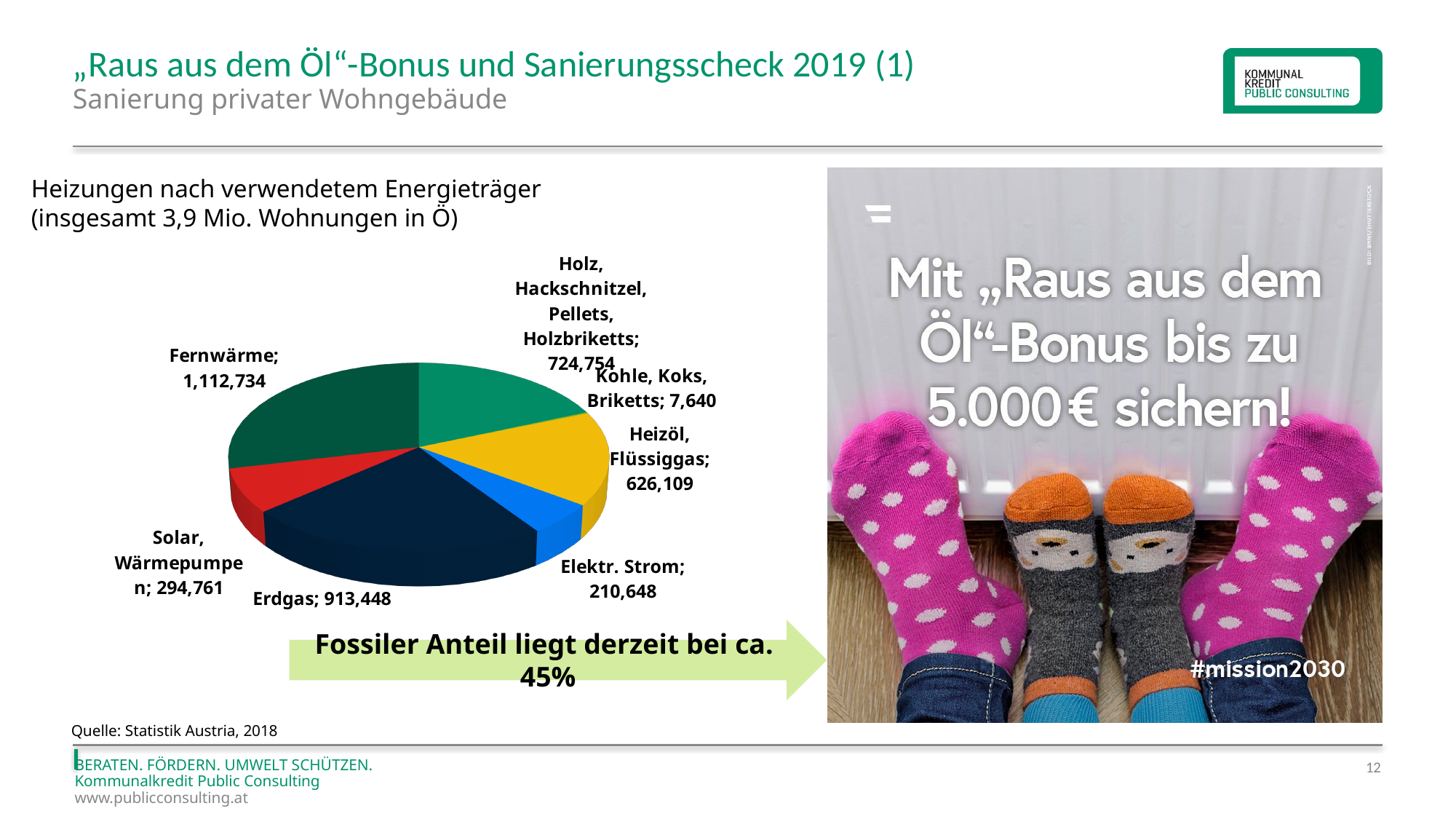
What is the value for Fernwärme in the pie chart? 1,112,734 What is the value for Elektr. Strom in the pie chart? 210,648 What kind of chart is shown on the slide? Pie chart How many categories (energy sources) does the pie chart show? 7 What is the difference between the values for Fernwärme and Erdgas? 199,286 Which category has the smallest value in the pie chart? Kohle, Koks, Briketts Which category has the largest value in the pie chart? Fernwärme What is the value for Heizöl, Flüssiggas in the pie chart? 626,109 What is the value for Erdgas in the pie chart? 913,448 Which is larger in the pie chart: Erdgas or Holz, Hackschnitzel, Pellets, Holzbriketts? Erdgas What is the difference between the values for Heizöl, Flüssiggas and Elektr. Strom? 415,461 What source is cited for the chart data? Statistik Austria, 2018